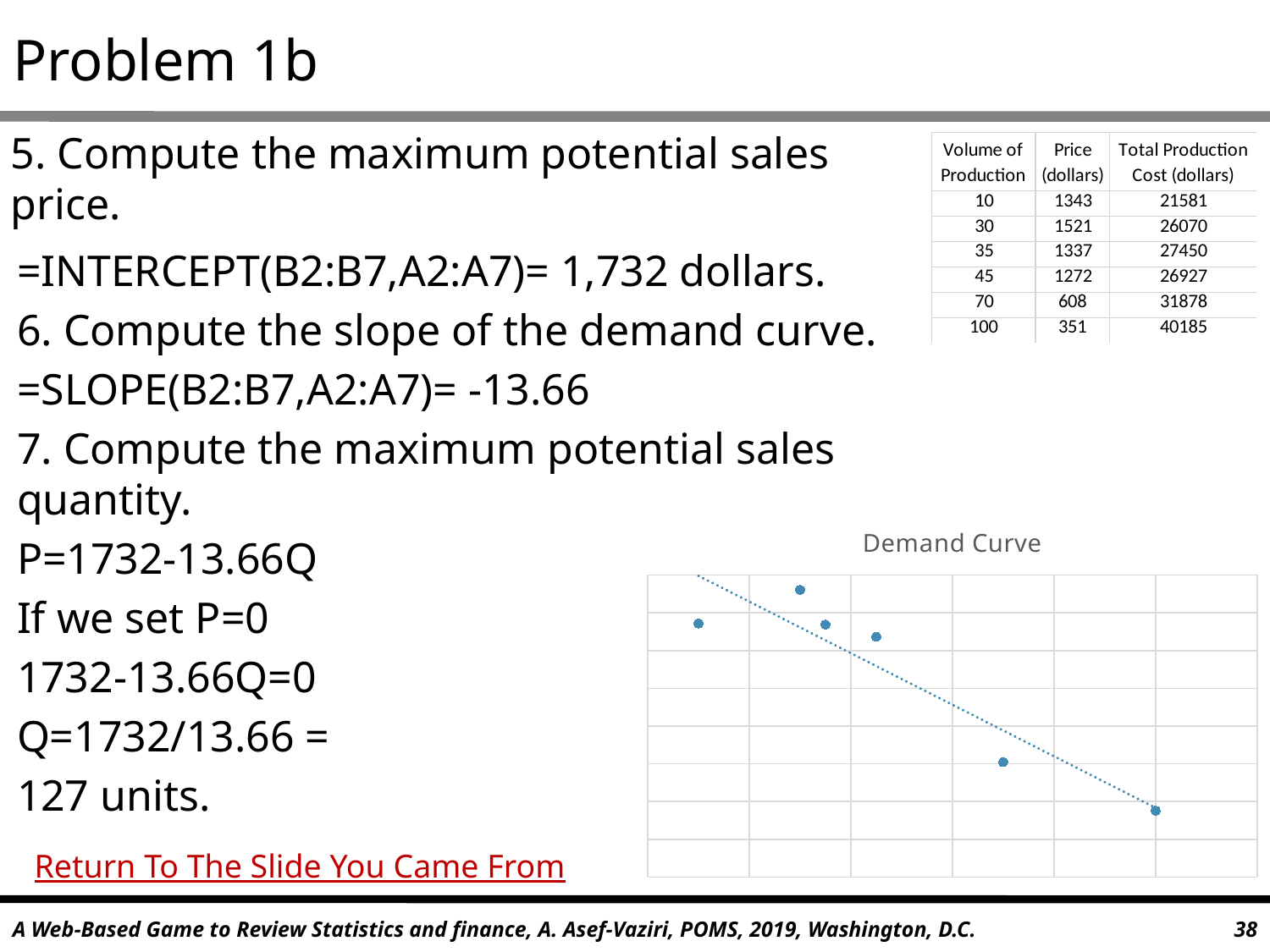
How many data points are plotted in the Demand Curve chart? 6 In the Demand Curve chart, do the plotted values generally rise or fall as you move from left to right along the x axis? fall What kind of chart is the Demand Curve chart? scatter chart Does the Demand Curve chart include a dotted trendline through the points? yes What is the title of the chart on the slide? Demand Curve